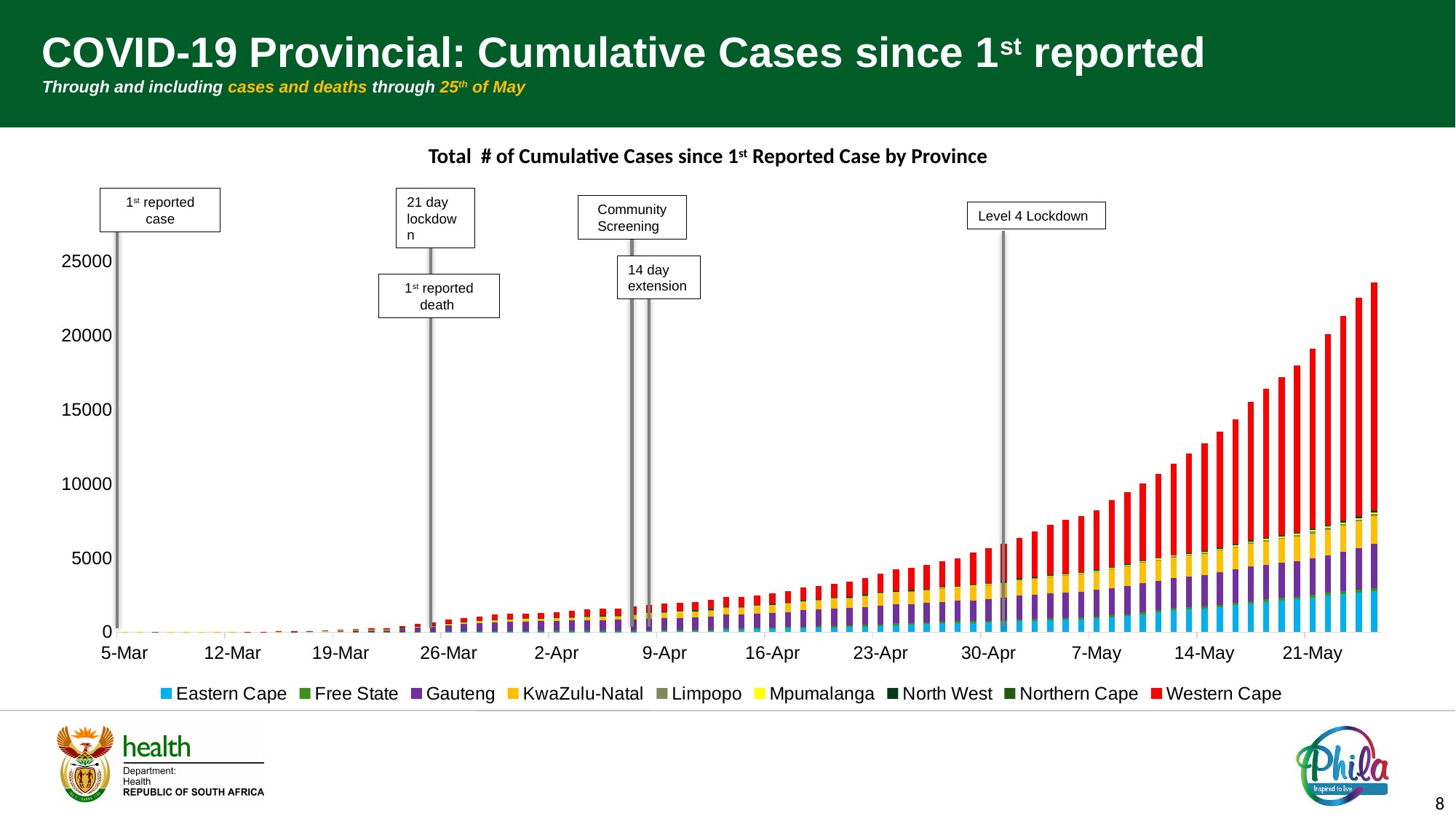
What kind of chart is shown on the slide? Stacked bar chart Which province accounts for the largest segment of the rightmost bar? Western Cape Which province is shown in red in the legend? Western Cape Is the total cumulative cases for the rightmost (latest) bar greater or less than 20000? greater How many provinces (series) does the legend list? 9 Is the total cumulative cases on 7-May greater or less than 10000? less How many date labels are shown on the x axis? 12 Which is larger, the total cumulative cases on 14-May or on 7-May? 14-May Do the cumulative case totals rise or fall from 5-Mar to the end of May? Rise Is the total cumulative cases on 14-May greater or less than 10000? greater What is the title of the chart? Total # of Cumulative Cases since 1st Reported Case by Province